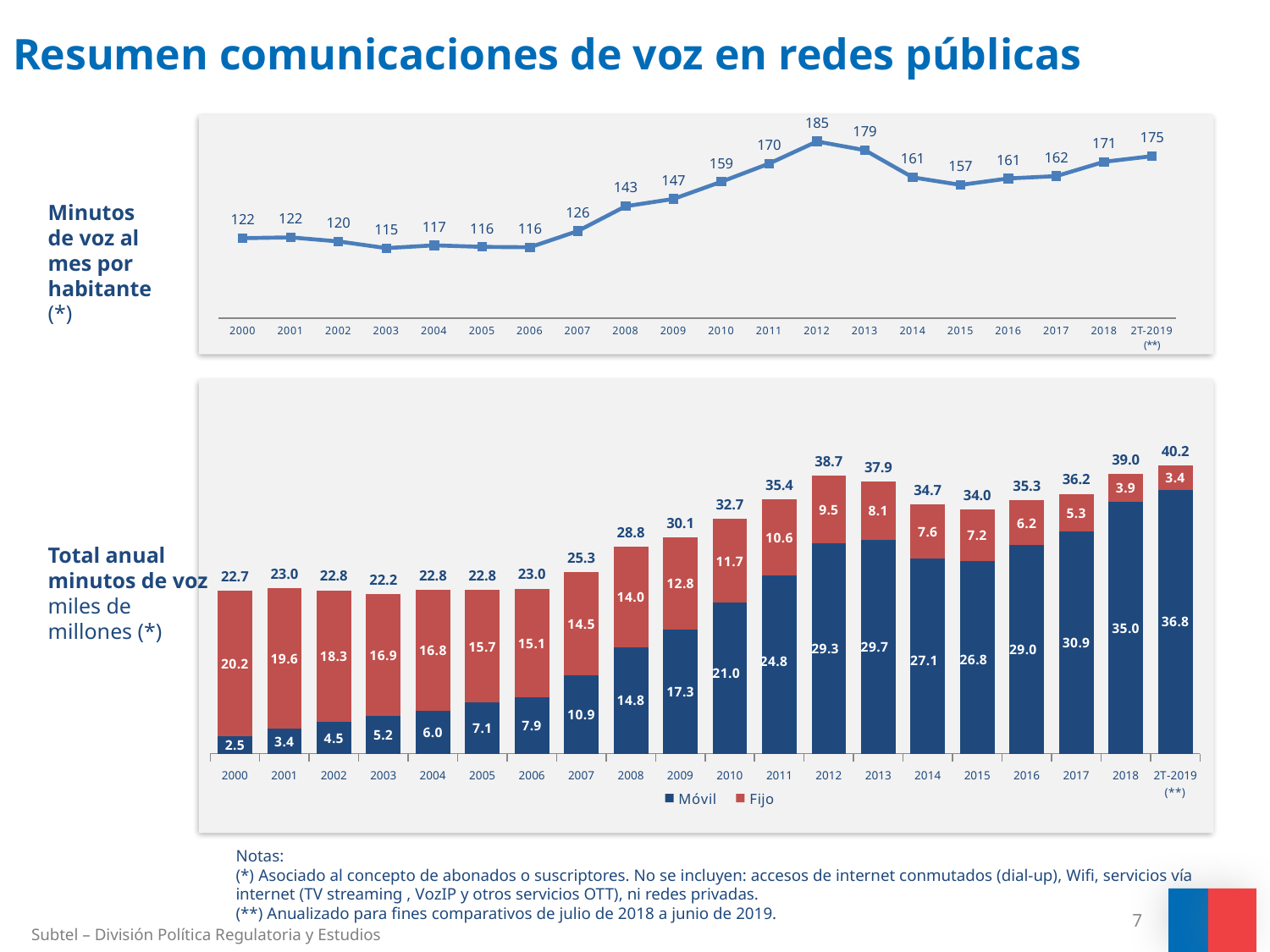
In the bottom chart (Total anual minutos de voz), what is the total for 2T-2019? 40.2 In the top chart (Minutos de voz al mes por habitante), which year has the lowest value? 2003 In the bottom chart (Total anual minutos de voz), what is the Fijo value for 2000? 20.2 What kind of chart is the top chart (Minutos de voz al mes por habitante)? Line chart In the top chart (Minutos de voz al mes por habitante), what is the difference between the values for 2018 and 2000? 49 In the bottom chart (Total anual minutos de voz), what is the difference between the Fijo values for 2000 and 2T-2019? 16.8 In the bottom chart (Total anual minutos de voz), does the Móvil value rise or fall from 2000 to 2012? Rise In the bottom chart (Total anual minutos de voz), how many series does the legend list? 2 In the top chart (Minutos de voz al mes por habitante), which year has the highest value? 2012 In the bottom chart (Total anual minutos de voz), what is the Móvil value for 2010? 21.0 In the top chart (Minutos de voz al mes por habitante), what is the value for 2012? 185 In the bottom chart (Total anual minutos de voz), which is larger in 2008: Móvil or Fijo? Móvil